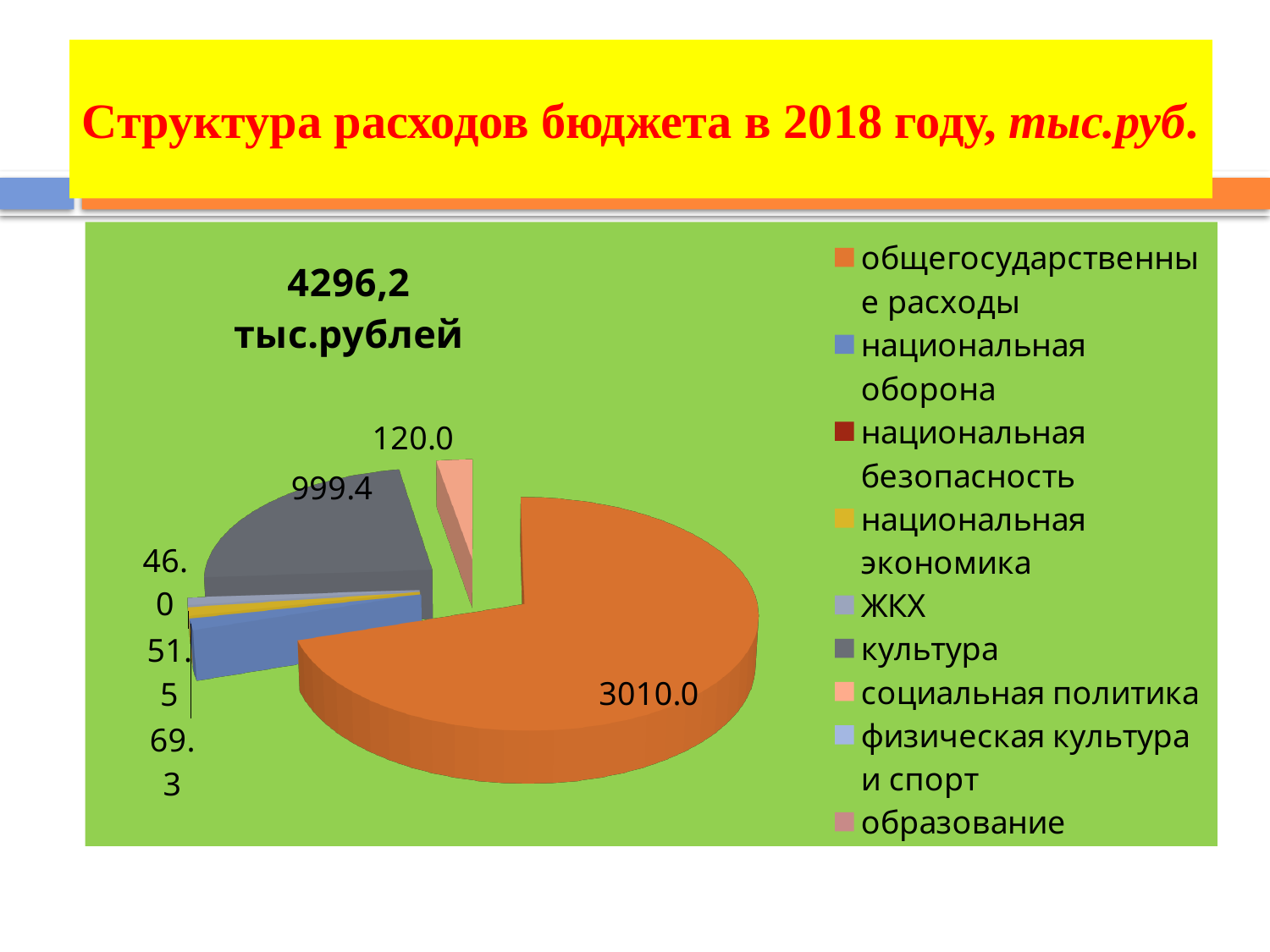
What is the value for культура? 999.4 What is the difference between общегосударственные расходы and культура? 2010.6 What is the title shown above the pie chart? 4296,2 тыс.рублей What is the difference between культура and социальная политика? 879.4 What colour is the slice for общегосударственные расходы? orange What is the value for социальная политика? 120.0 How many entries does the legend list? 9 Which category has the largest slice of the pie? общегосударственные расходы What is the value for общегосударственные расходы? 3010.0 What kind of chart is shown on the slide? pie chart Which is larger, культура or социальная политика? культура